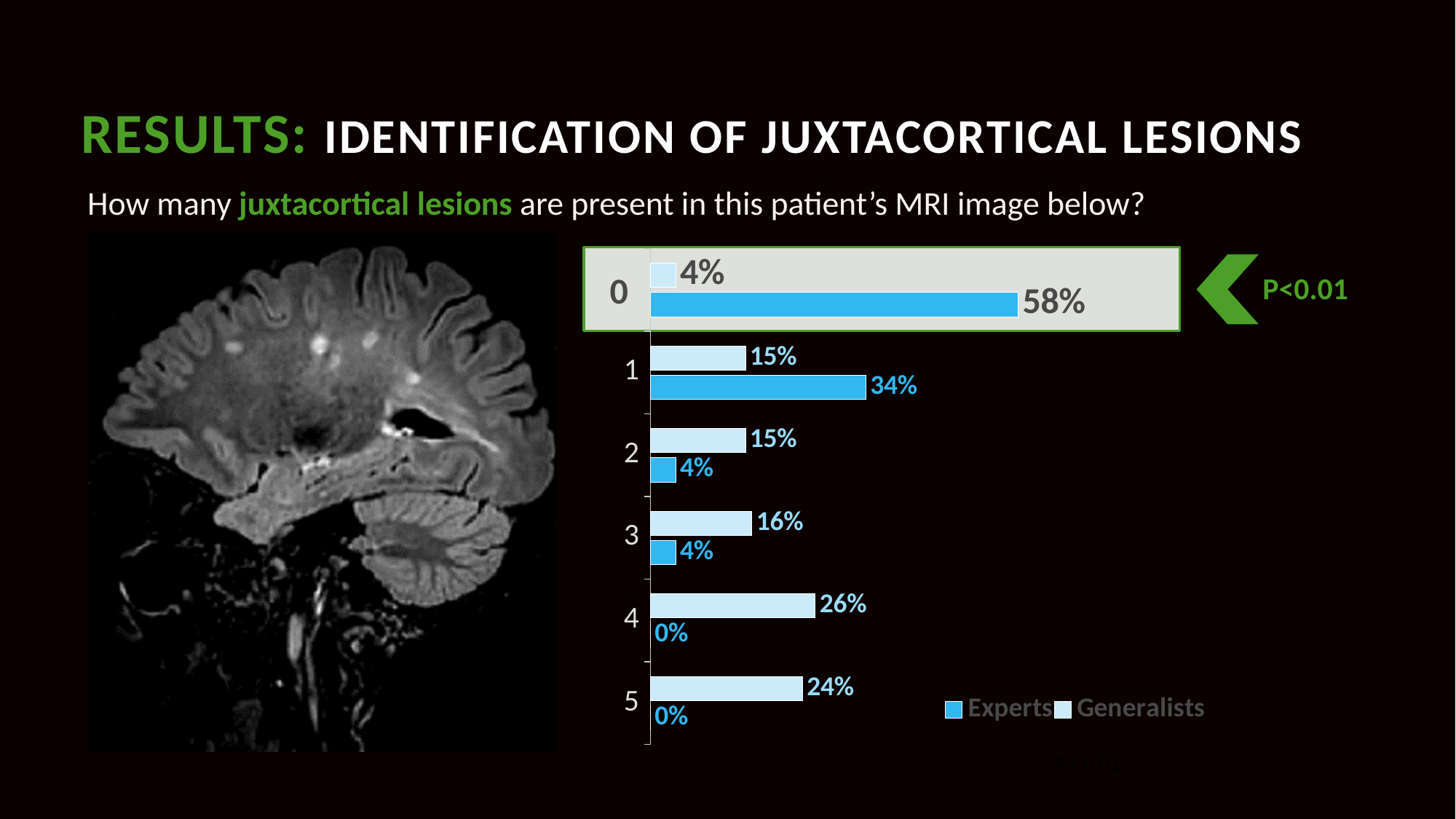
How many series does the chart legend list? 2 Which answer category has the highest percentage of Experts? 0 How many answer categories are shown on the chart? 6 What p-value is shown next to the highlighted answer category 0? P<0.01 What percentage of Generalists answered 4 juxtacortical lesions? 26% For the answer 2, which group has the larger percentage, Experts or Generalists? Generalists Which answer category has the highest percentage of Generalists? 4 What type of chart is shown on the slide? Bar chart What percentage of Experts answered 0 juxtacortical lesions? 58% What percentage of Experts answered 1 juxtacortical lesion? 34% What is the difference between the Experts and Generalists percentages for the answer 0? 54% What percentage of Generalists answered 5 juxtacortical lesions? 24%